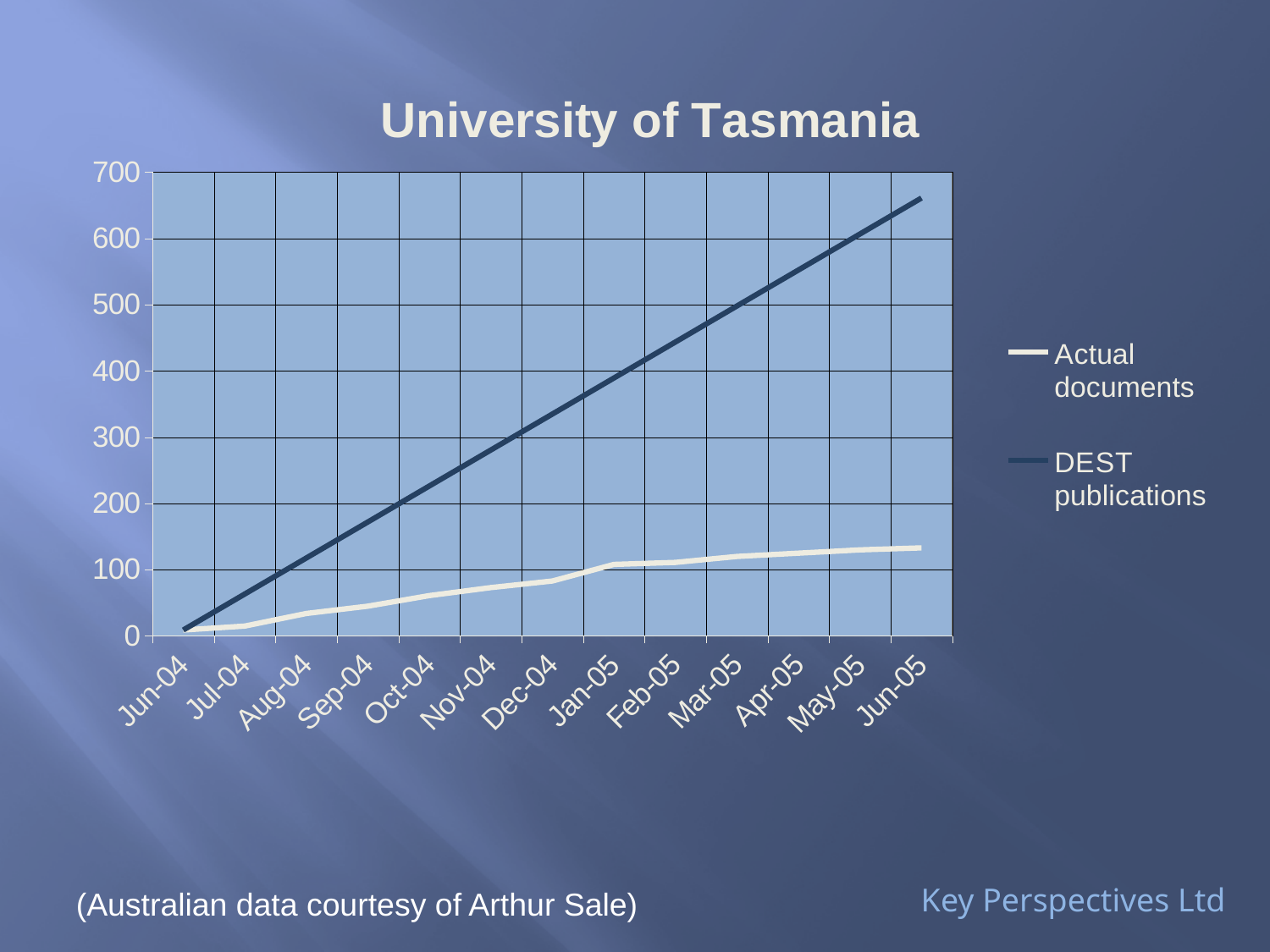
How many series does the legend list? 2 Do the DEST publications values rise or fall from Jun-04 to Jun-05? rise What is the first month shown on the x axis? Jun-04 What is the title of the chart? University of Tasmania What kind of chart is shown on the slide? line chart Which series is higher at Jun-05, Actual documents or DEST publications? DEST publications Is the value for Actual documents at Jun-05 greater or less than 100? greater Is the value for DEST publications at Jun-05 greater or less than 600? greater Is the value for Actual documents at Dec-04 greater or less than 100? less How many months are plotted along the x axis? 13